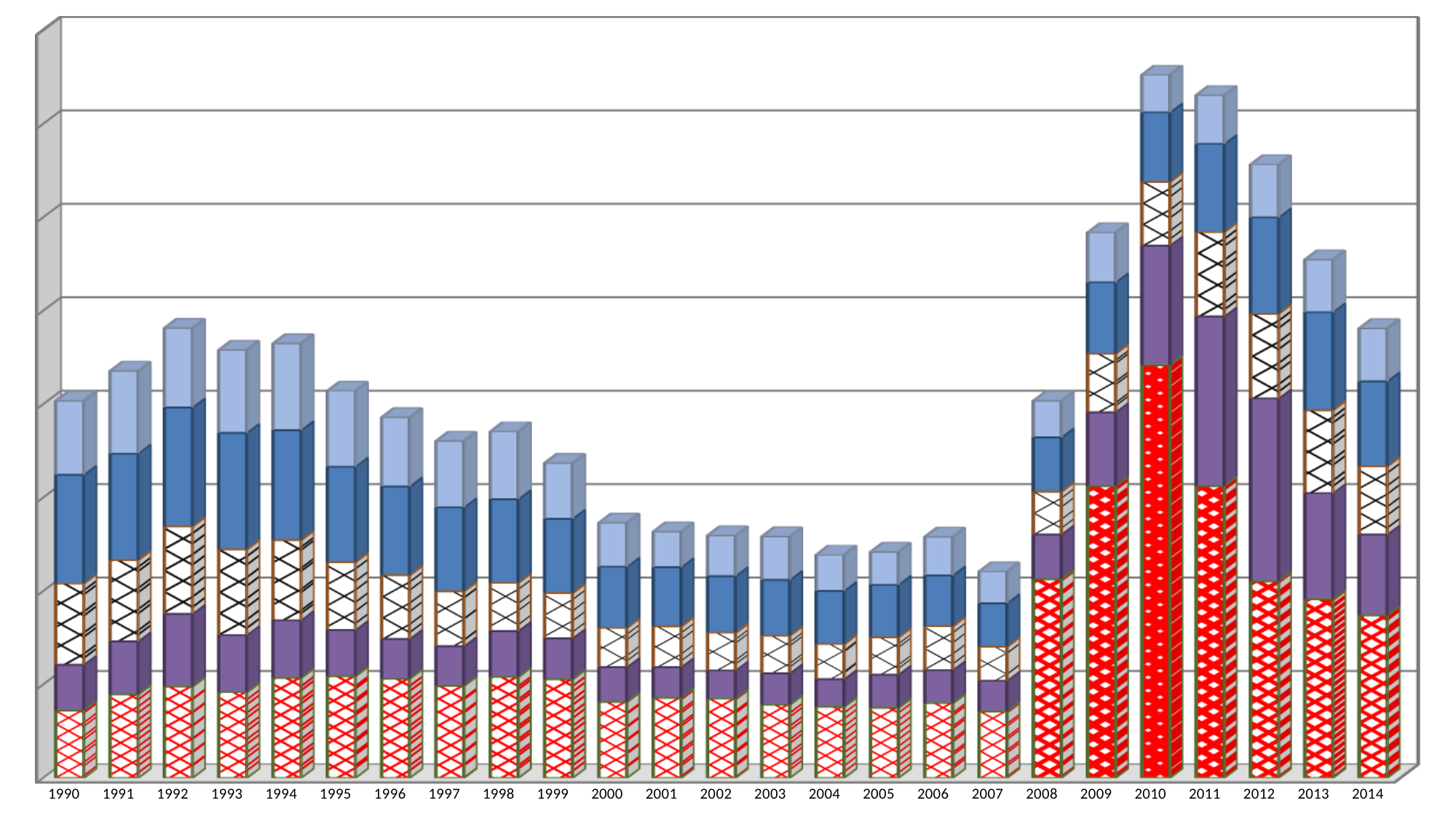
Do the stacked bar totals rise or fall from 2007 to 2010? Rise How many segments make up each stacked bar? 5 Which year has the taller stacked bar, 1990 or 1992? 1992 Which year has the taller stacked bar, 2008 or 2009? 2009 What is the first year shown on the x axis? 1990 What kind of chart is shown on the slide? Stacked bar chart How many years are shown along the x axis of the chart? 25 Which year has the shortest stacked bar? 2007 Which year has the taller stacked bar, 2010 or 2011? 2010 Do the stacked bar totals rise or fall from 2000 to 2004? Fall Which year has the tallest stacked bar? 2010 Do the stacked bar totals rise or fall from 2010 to 2014? Fall